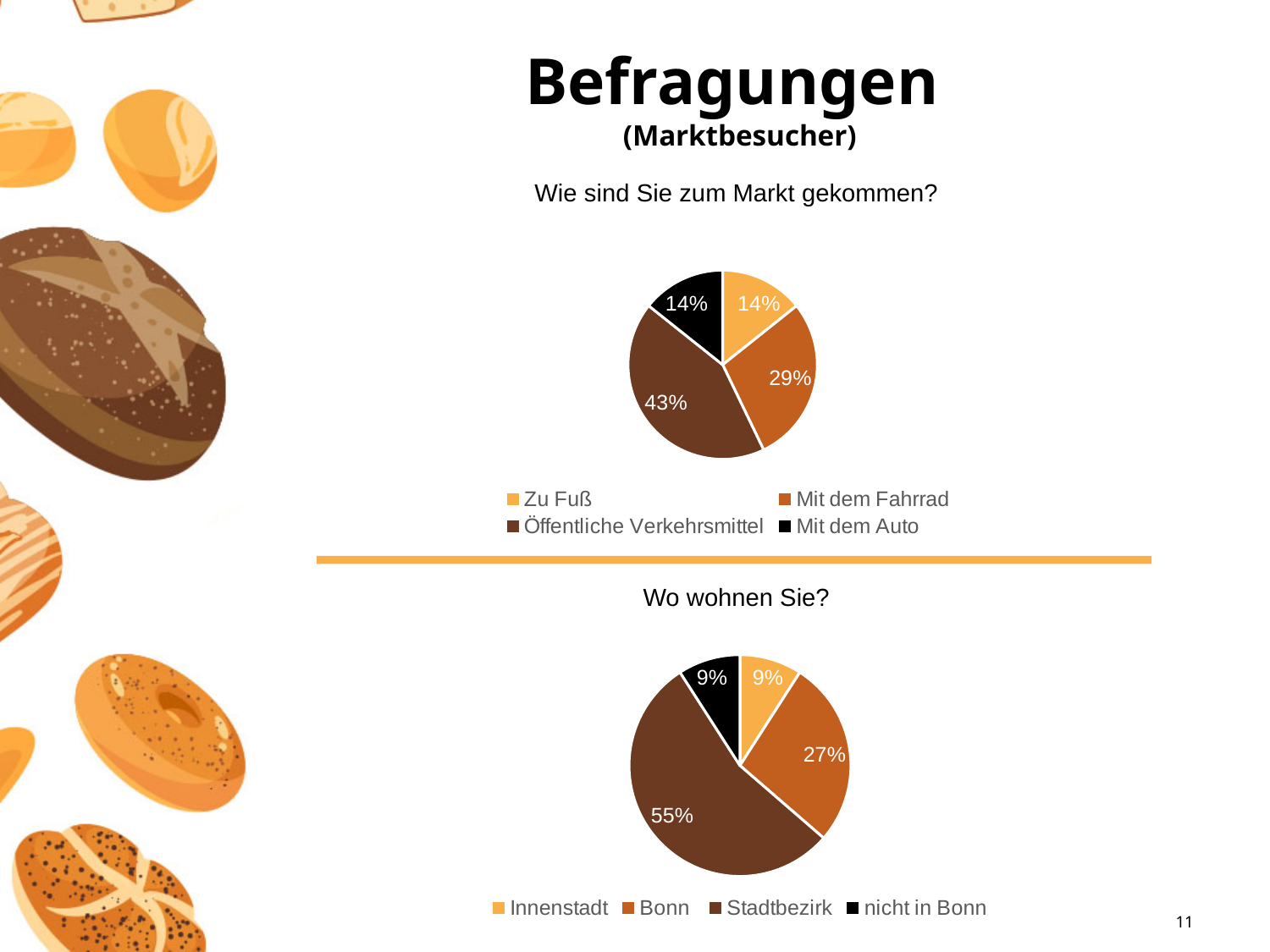
In the chart titled "Wie sind Sie zum Markt gekommen?", how many categories does the legend list? 4 In the chart titled "Wie sind Sie zum Markt gekommen?", what share of respondents came by Öffentliche Verkehrsmittel? 43% In the chart titled "Wo wohnen Sie?", what share of respondents live in the Stadtbezirk? 55% In the chart titled "Wo wohnen Sie?", what is the difference between the Stadtbezirk share and the Bonn share? 28% In the chart titled "Wie sind Sie zum Markt gekommen?", which category has the largest slice? Öffentliche Verkehrsmittel In the chart titled "Wie sind Sie zum Markt gekommen?", what is the difference between the Öffentliche Verkehrsmittel share and the Mit dem Fahrrad share? 14% What kind of chart is used for "Wo wohnen Sie?"? Pie chart In the chart titled "Wo wohnen Sie?", what share of respondents live in Bonn? 27% In the chart titled "Wie sind Sie zum Markt gekommen?", which colour represents Mit dem Auto? Black In the chart titled "Wie sind Sie zum Markt gekommen?", what share of respondents came Mit dem Fahrrad? 29% In the chart titled "Wo wohnen Sie?", which category has the largest slice? Stadtbezirk In the chart titled "Wo wohnen Sie?", which is larger: the share for Bonn or the share for Innenstadt? Bonn